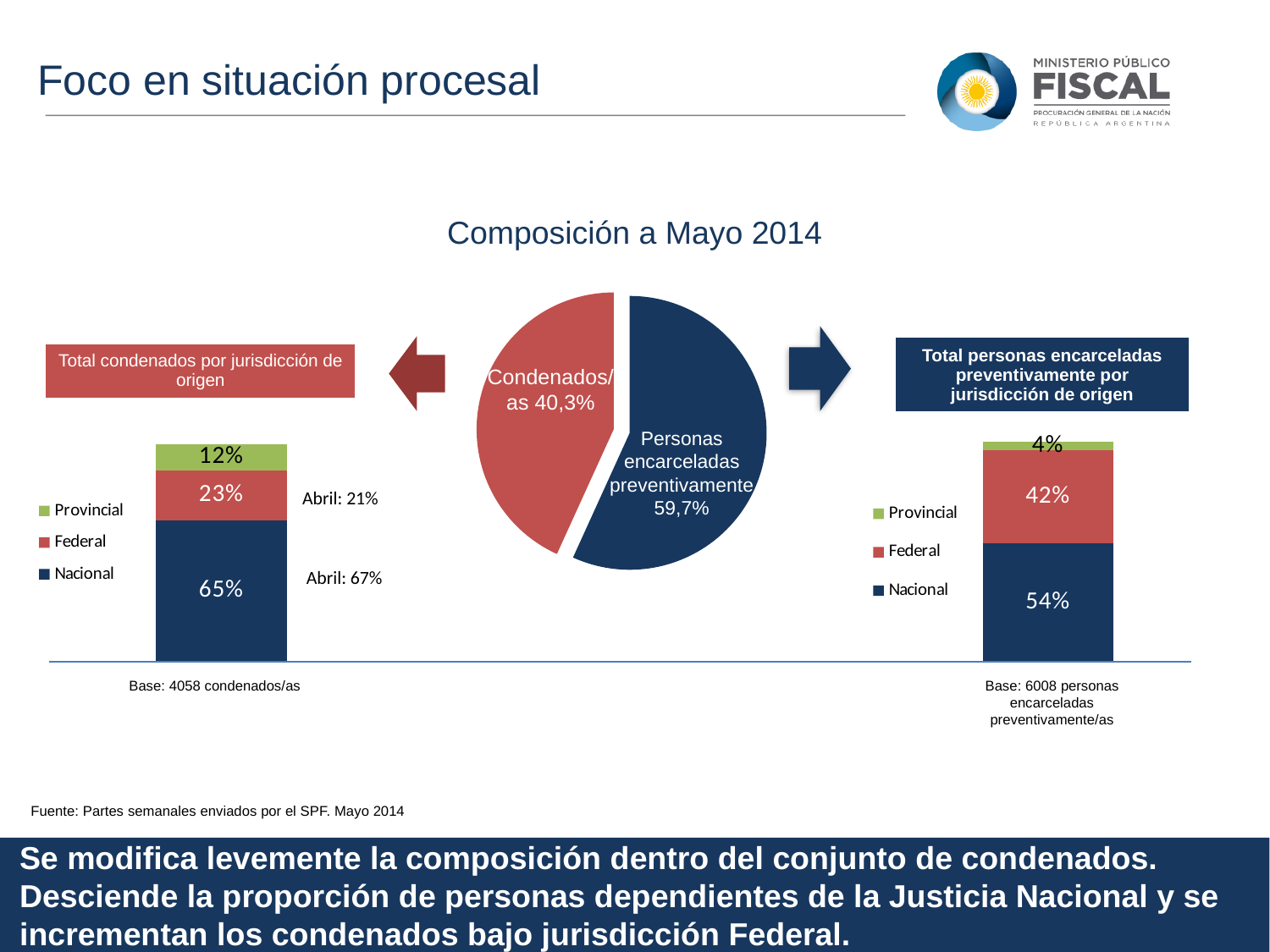
In the pie chart 'Composición a Mayo 2014', what share is labelled for 'Condenados/as'? 40,3% In the pie chart 'Composición a Mayo 2014', which slice is larger, 'Condenados/as' or 'Personas encarceladas preventivamente'? Personas encarceladas preventivamente In the right chart 'Total personas encarceladas preventivamente por jurisdicción de origen', what is the value for 'Federal'? 42% In the left chart 'Total condenados por jurisdicción de origen', which segment is the largest? Nacional In the left chart 'Total condenados por jurisdicción de origen', what is the value for 'Federal'? 23% In the left chart 'Total condenados por jurisdicción de origen', what is the value for 'Nacional'? 65% In the pie chart 'Composición a Mayo 2014', what share is labelled for 'Personas encarceladas preventivamente'? 59,7% In the right chart 'Total personas encarceladas preventivamente por jurisdicción de origen', which segment is the smallest? Provincial In the left chart 'Total condenados por jurisdicción de origen', what is the value for 'Provincial'? 12% In the pie chart 'Composición a Mayo 2014', how many slices are there? 2 How many series does the legend of the right chart 'Total personas encarceladas preventivamente por jurisdicción de origen' list? 3 In the left chart 'Total condenados por jurisdicción de origen', what is the difference between the 'Nacional' and 'Federal' values? 42%